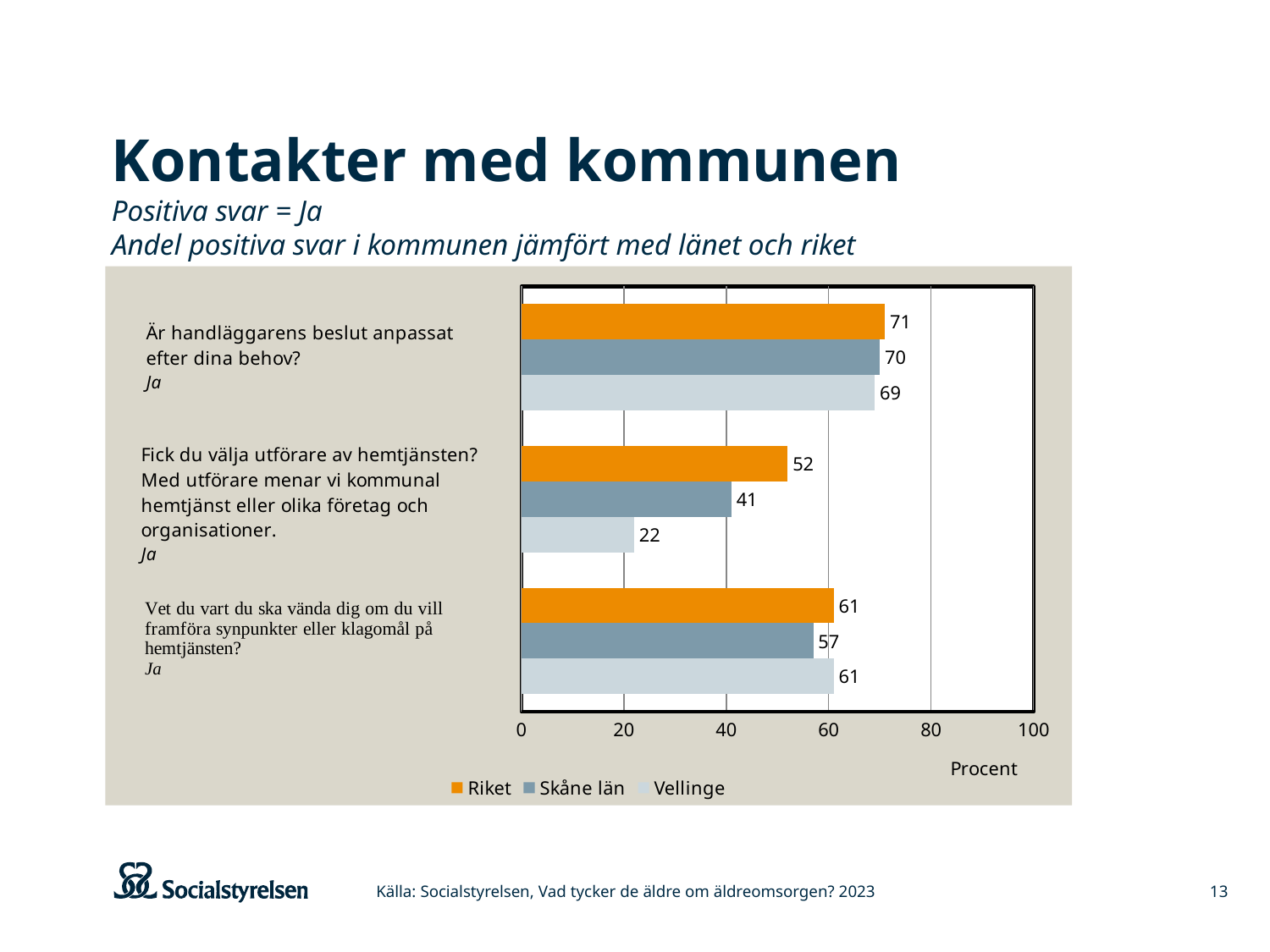
Is the value for Vellinge on the question "Är handläggarens beslut anpassat efter dina behov?" greater or less than 60? greater What is the value for Riket on the question "Är handläggarens beslut anpassat efter dina behov?"? 71 Which is larger on the question "Fick du välja utförare av hemtjänsten?": Skåne län or Vellinge? Skåne län Which series has the lowest value on the question "Fick du välja utförare av hemtjänsten?"? Vellinge How many questions (categories) are shown on the chart? 3 How many series does the legend list? 3 What is the difference between Riket and Vellinge on the question "Fick du välja utförare av hemtjänsten?"? 30 What is the value for Vellinge on the question "Fick du välja utförare av hemtjänsten?"? 22 What is the value for Skåne län on the question "Vet du vart du ska vända dig om du vill framföra synpunkter eller klagomål på hemtjänsten?"? 57 What is the difference between Riket and Skåne län on the question "Vet du vart du ska vända dig om du vill framföra synpunkter eller klagomål på hemtjänsten?"? 4 What kind of chart is shown on the slide? Bar chart Which series has the highest value on the question "Fick du välja utförare av hemtjänsten?"? Riket